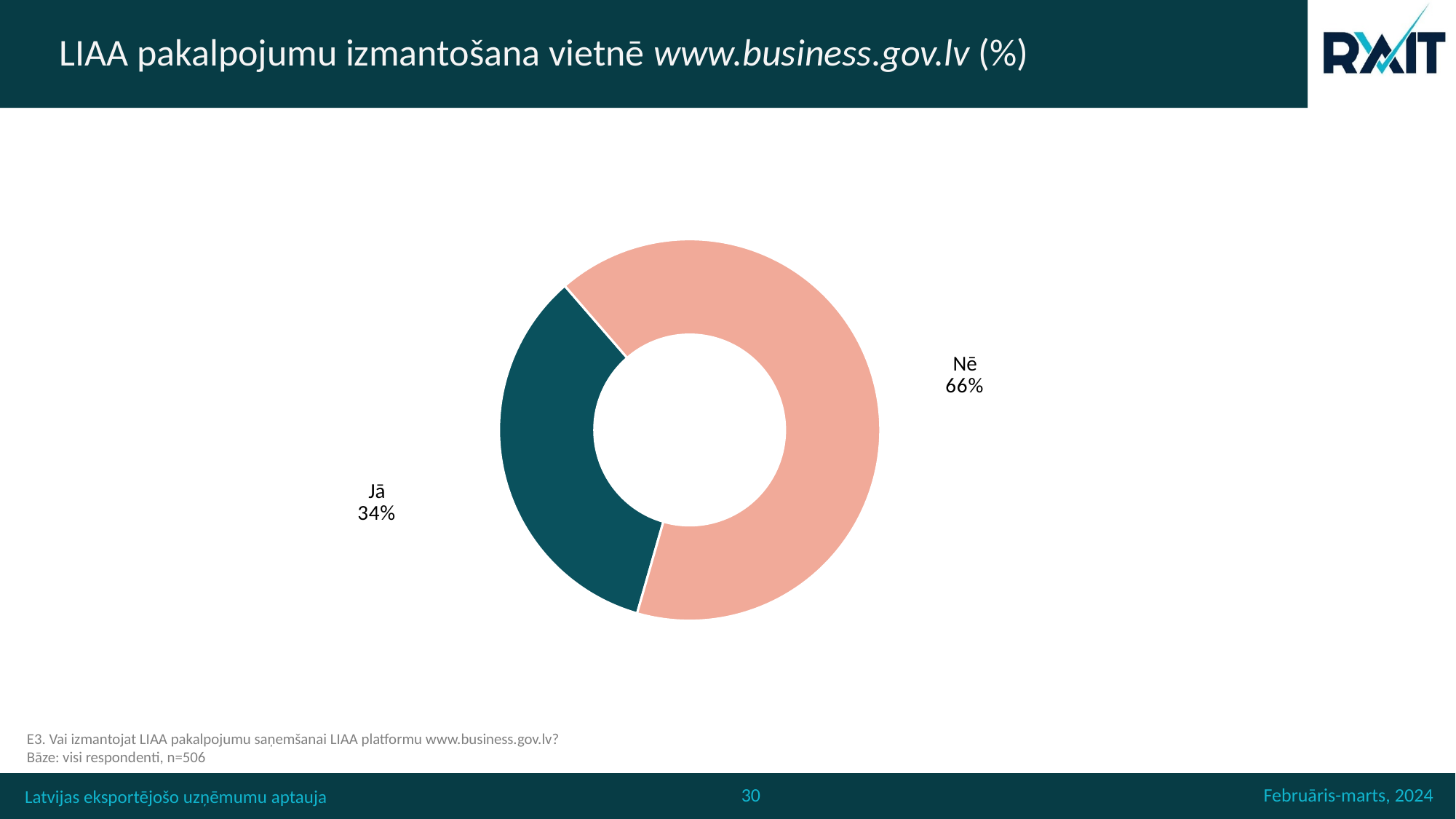
Which category has the smallest share of the chart? Jā What share of the chart does the "Nē" slice represent? 66% Which category has the largest share of the chart? Nē What percentage of respondents answered "Nē"? 66% What colour is the "Jā" slice? Dark teal What kind of chart is shown on the slide? Doughnut (pie) chart What is the difference in percentage points between "Nē" and "Jā"? 32 Which is larger, the share for "Jā" or the share for "Nē"? Nē How many categories are shown in the chart? 2 What is the base (n) of respondents stated on the slide? n=506 What percentage of respondents answered "Jā"? 34%